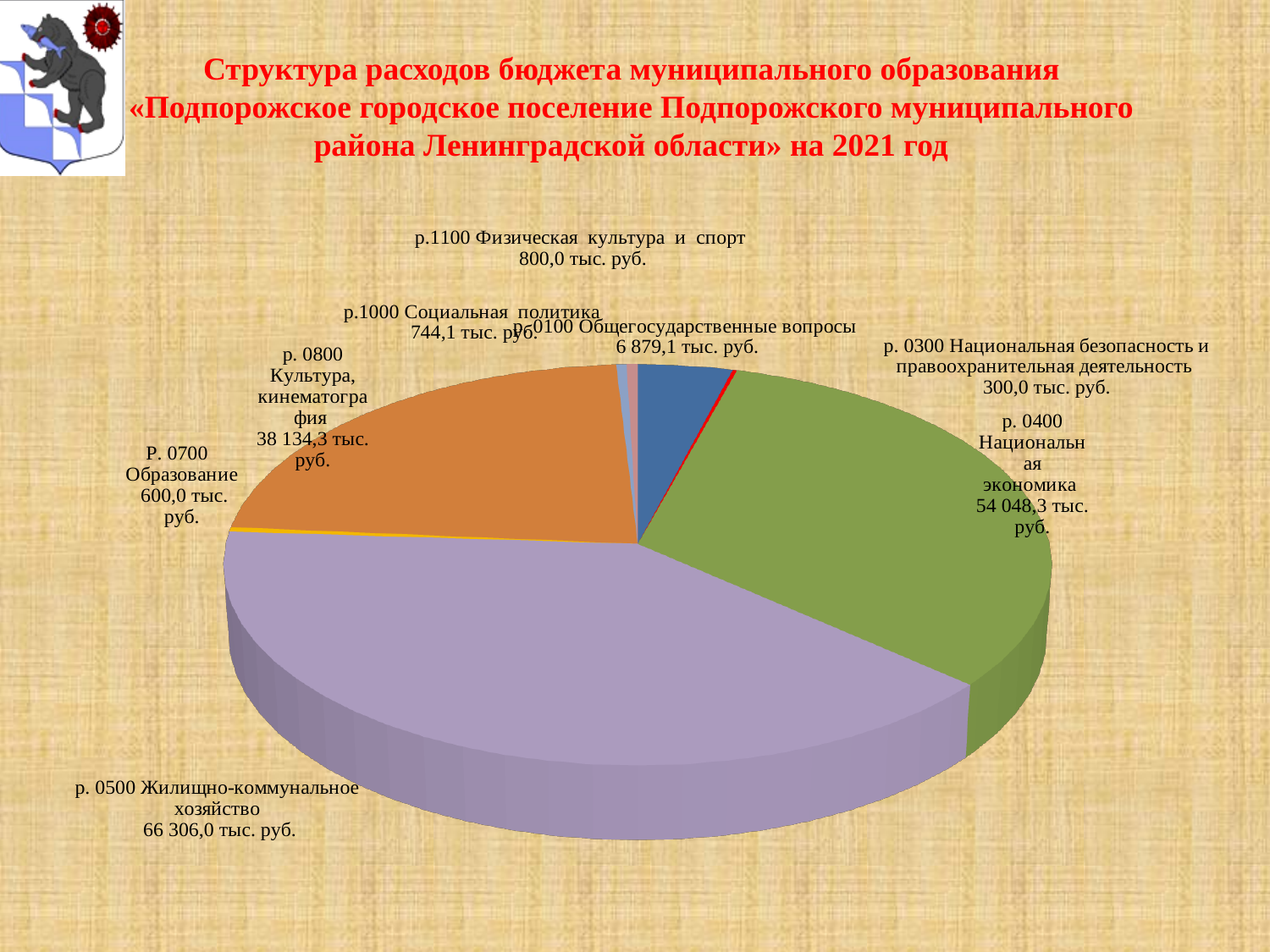
Which category has the smallest value? р. 0300 Национальная безопасность и правоохранительная деятельность Which category has the largest share of the pie? р. 0500 Жилищно-коммунальное хозяйство What kind of chart is shown on the slide? Pie chart Which is larger: р.1100 Физическая культура и спорт or р.1000 Социальная политика? р.1100 Физическая культура и спорт What is the value for р.0100 Общегосударственные вопросы? 6 879,1 тыс. руб. What year does the chart title say the budget expenditure structure is for? 2021 What is the value for р. 0300 Национальная безопасность и правоохранительная деятельность? 300,0 тыс. руб. What is the value for р. 0800 Культура, кинематография? 38 134,3 тыс. руб. What is the value for р. 0500 Жилищно-коммунальное хозяйство? 66 306,0 тыс. руб. How many categories (slices) does the pie chart show? 8 What is the difference between р. 0500 Жилищно-коммунальное хозяйство and р. 0400 Национальная экономика? 12 257,7 тыс. руб. What is the value for р. 0400 Национальная экономика? 54 048,3 тыс. руб.